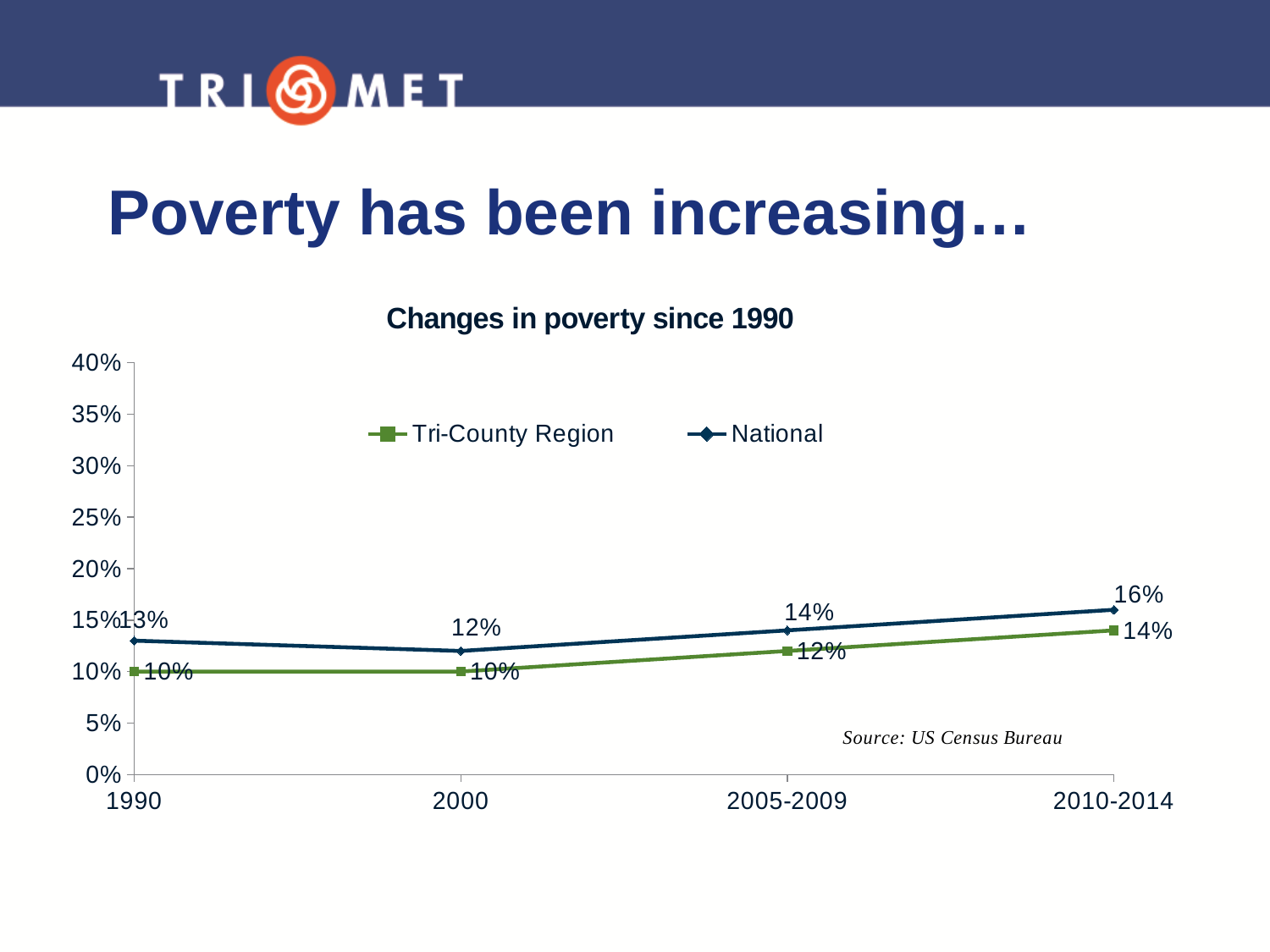
What is the National poverty rate for 2010-2014? 16% What is the title of the chart? Changes in poverty since 1990 What is the National poverty rate in 2000? 12% What is the Tri-County Region poverty rate in 1990? 10% Which series has the higher value for 2010-2014, National or Tri-County Region? National What is the difference between the National and Tri-County Region poverty rates in 1990? 3% In which year is the National poverty rate lowest? 2000 What kind of chart is shown on the slide? Line chart How many series does the legend list? 2 In which period is the Tri-County Region poverty rate highest? 2010-2014 How many time periods are shown on the x axis? 4 What is the Tri-County Region poverty rate for 2005-2009? 12%